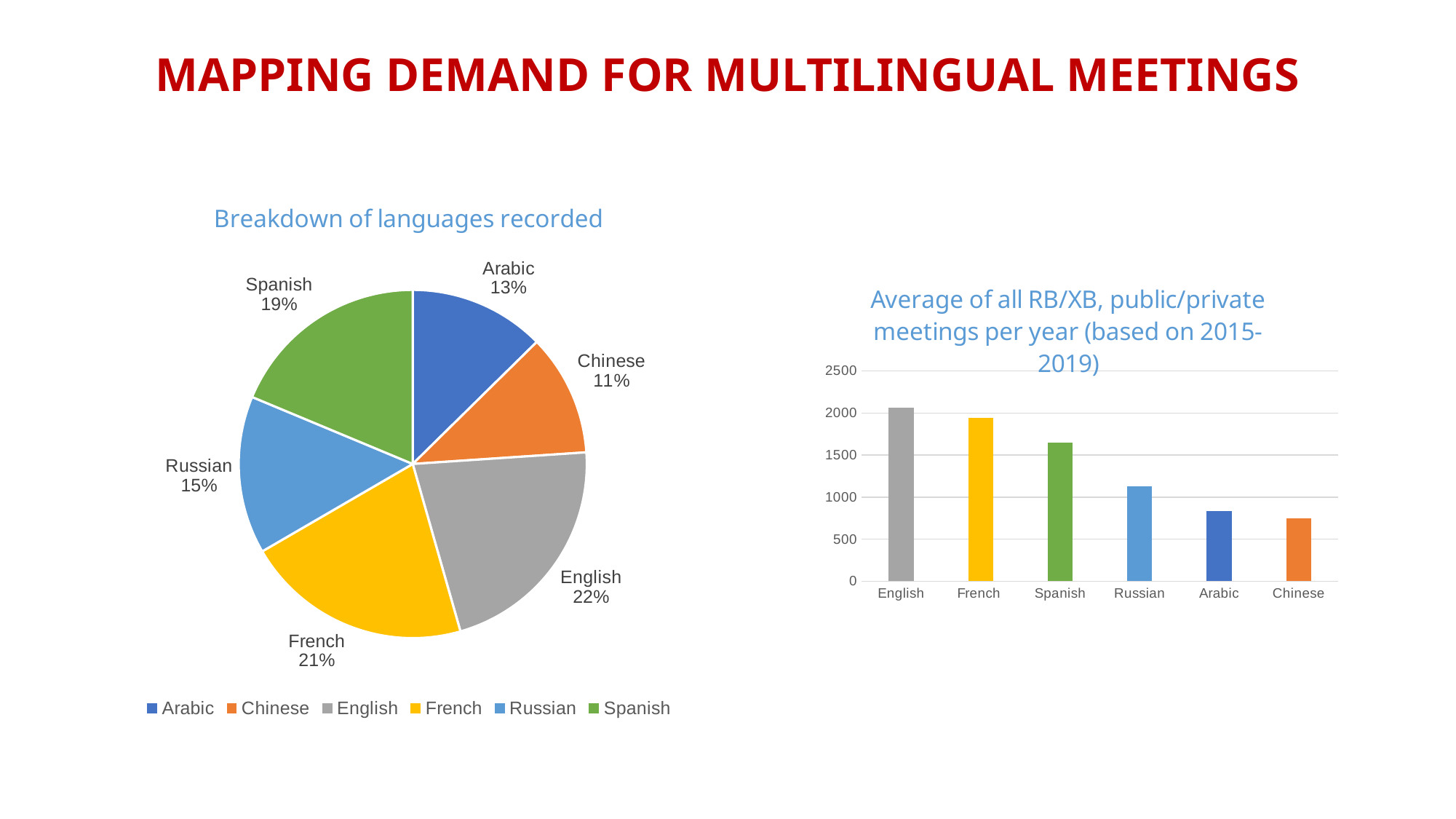
In the 'Average of all RB/XB, public/private meetings per year' chart, is the value for Arabic greater or less than 1000? less In the 'Breakdown of languages recorded' chart, what share does Russian have? 15% In the 'Breakdown of languages recorded' chart, how many languages does the legend list? 6 In the 'Average of all RB/XB, public/private meetings per year' chart, which language has the lowest value? Chinese In the 'Average of all RB/XB, public/private meetings per year' chart, which language has the highest value? English In the 'Breakdown of languages recorded' chart, which language has the smallest share? Chinese In the 'Breakdown of languages recorded' chart, what is the difference in percentage points between Spanish and Arabic? 6 What kind of chart is 'Breakdown of languages recorded'? pie chart In the 'Breakdown of languages recorded' chart, which language has the largest share? English What kind of chart is 'Average of all RB/XB, public/private meetings per year (based on 2015-2019)'? bar chart In the 'Average of all RB/XB, public/private meetings per year' chart, is the value for Spanish greater or less than 1500? greater In the 'Breakdown of languages recorded' chart, what share does English have? 22%